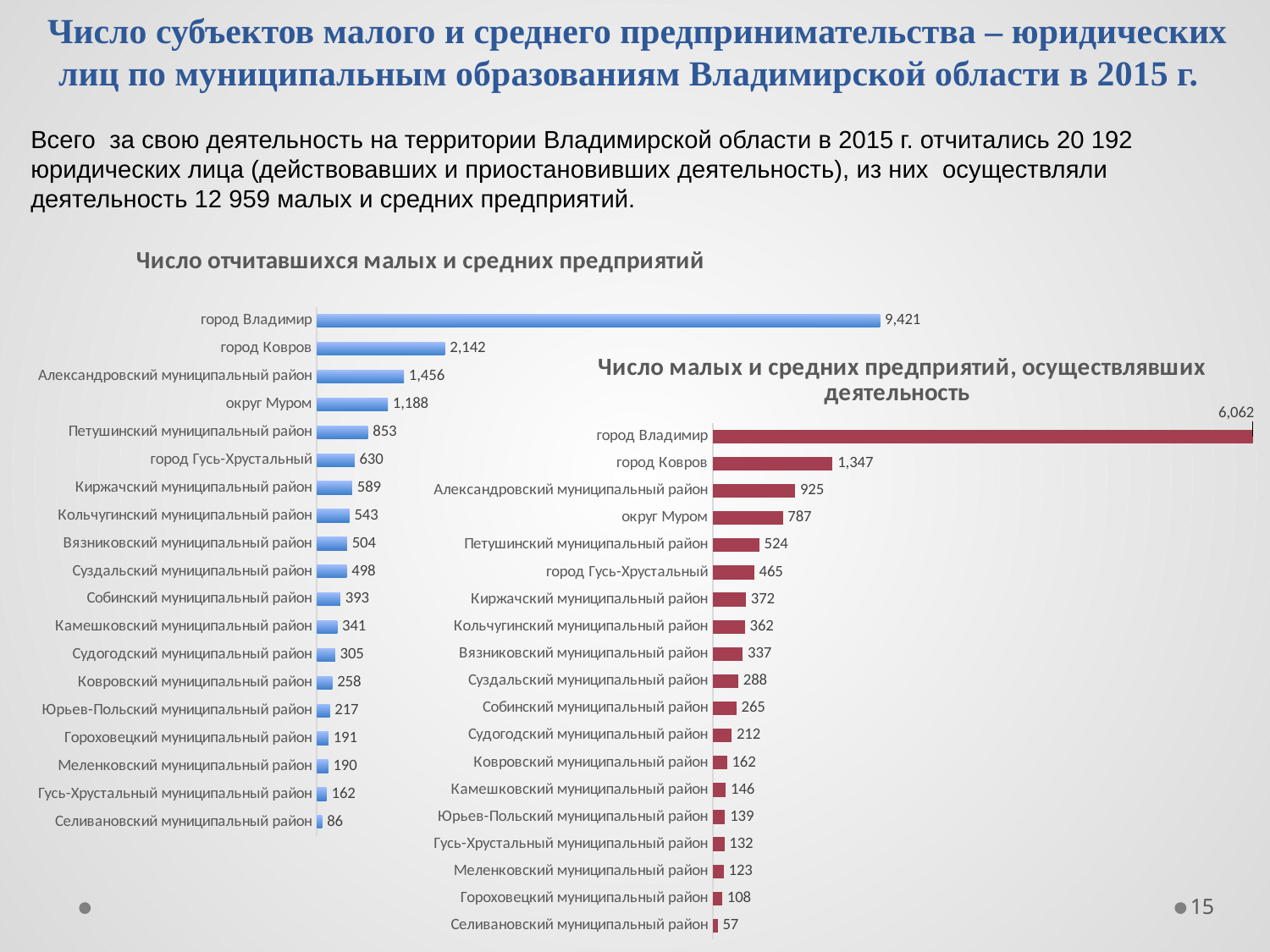
What colour are the bars in the chart "Число отчитавшихся малых и средних предприятий"? Blue How many categories are shown in the chart "Число малых и средних предприятий, осуществлявших деятельность"? 19 In the chart "Число отчитавшихся малых и средних предприятий", which category has the highest value? город Владимир In the chart "Число малых и средних предприятий, осуществлявших деятельность", what is the value for округ Муром? 787 In the chart "Число отчитавшихся малых и средних предприятий", what is the difference between город Владимир and город Ковров? 7,279 What kind of chart is "Число малых и средних предприятий, осуществлявших деятельность"? Bar chart In the chart "Число малых и средних предприятий, осуществлявших деятельность", which is larger: Ковровский муниципальный район or Камешковский муниципальный район? Ковровский муниципальный район In the chart "Число отчитавшихся малых и средних предприятий", which is larger: Киржачский муниципальный район or Кольчугинский муниципальный район? Киржачский муниципальный район In the chart "Число отчитавшихся малых и средних предприятий", what is the value for город Ковров? 2,142 In the chart "Число малых и средних предприятий, осуществлявших деятельность", what is the difference between Александровский муниципальный район and Петушинский муниципальный район? 401 In the chart "Число малых и средних предприятий, осуществлявших деятельность", which category has the lowest value? Селивановский муниципальный район How many categories are shown in the chart "Число отчитавшихся малых и средних предприятий"? 19